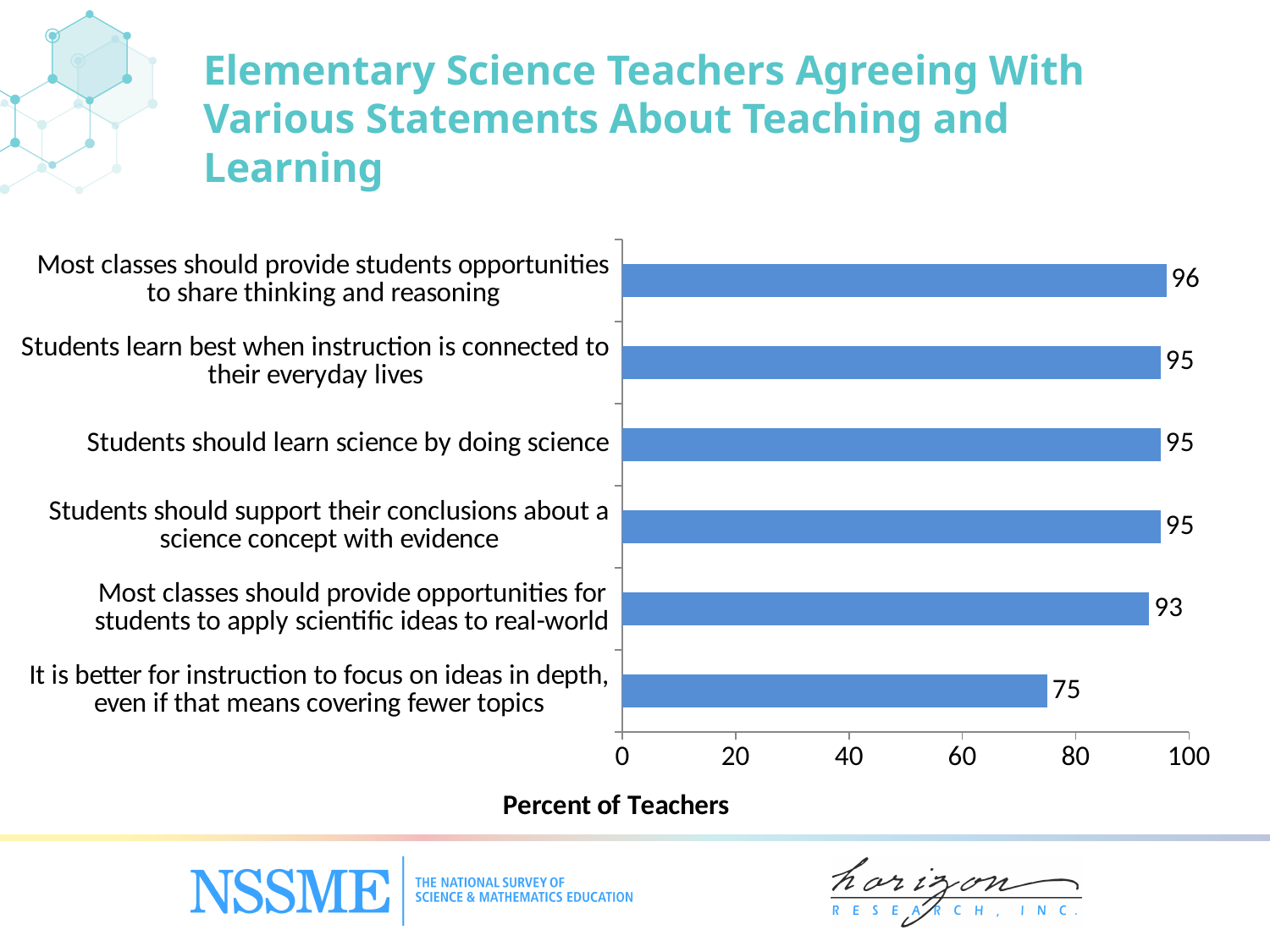
What percent of teachers agree that most classes should provide students opportunities to share thinking and reasoning? 96 What is the difference in percent of teachers between the statement about sharing thinking and reasoning and the statement about focusing on ideas in depth? 21 What kind of chart is shown on the slide? bar chart What percent of teachers agree that students should learn science by doing science? 95 Is the value for the statement about focusing on ideas in depth greater or less than 80? less What is the label of the horizontal axis? Percent of Teachers Which statement has the lowest percent of teachers agreeing? It is better for instruction to focus on ideas in depth, even if that means covering fewer topics Which has a higher percent of teachers agreeing: applying scientific ideas to real-world, or focusing on ideas in depth? Most classes should provide opportunities for students to apply scientific ideas to real-world What percent of teachers agree that it is better for instruction to focus on ideas in depth, even if that means covering fewer topics? 75 What percent of teachers agree that most classes should provide opportunities for students to apply scientific ideas to real-world? 93 Which statement has the highest percent of teachers agreeing? Most classes should provide students opportunities to share thinking and reasoning How many statements are shown in the chart? 6